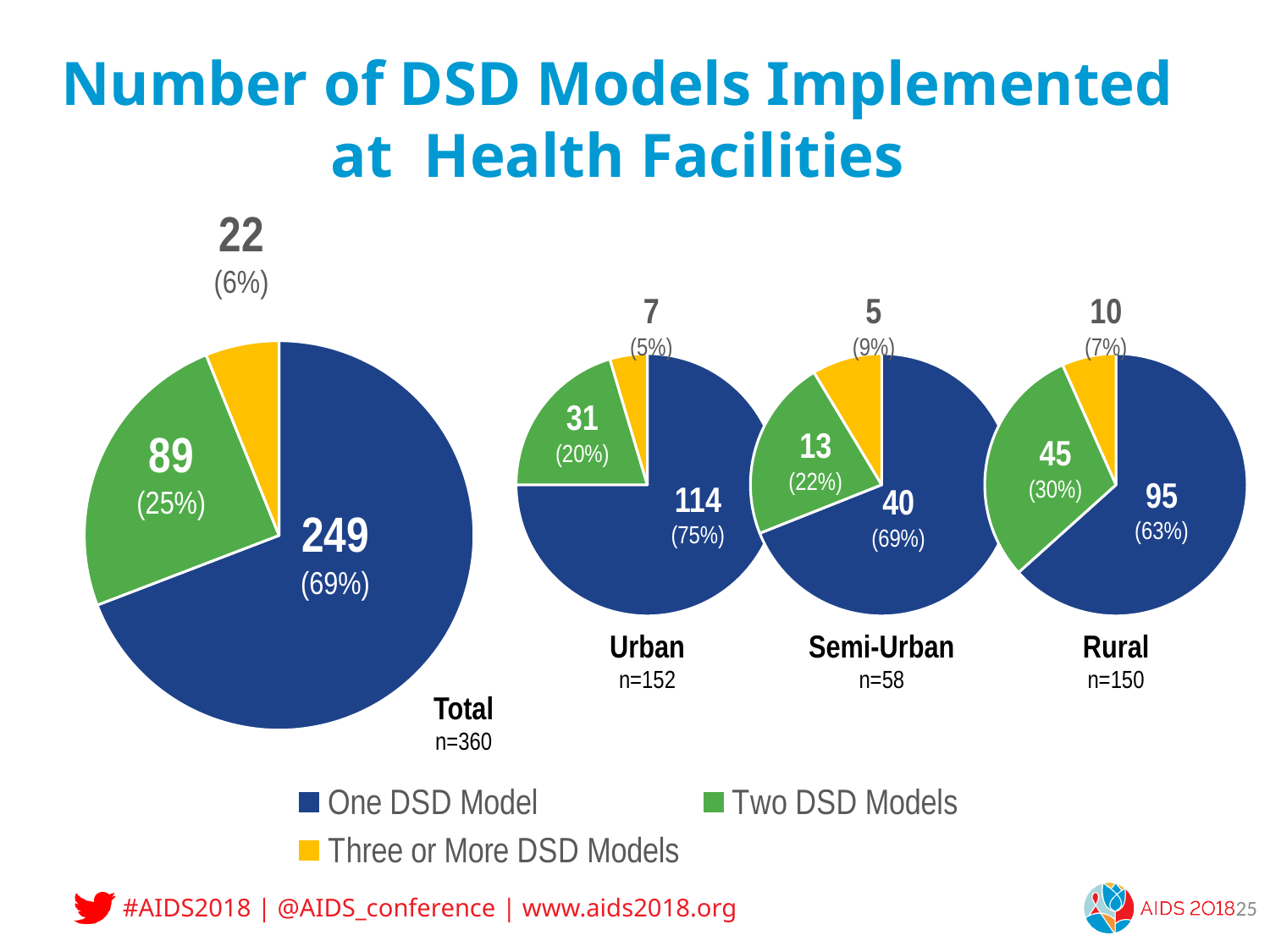
In the Rural pie chart, how many facilities implemented three or more DSD models? 10 Comparing the Urban and Rural pie charts, which has more facilities implementing two DSD models? Rural In the Total pie chart, how many health facilities implemented one DSD model? 249 In the Urban pie chart, what percentage of facilities implemented two DSD models? 20% In the Rural pie chart, what is the difference between the number of facilities with one DSD model and those with two DSD models? 50 How many categories does the legend list? 3 In the Total pie chart, which category has the smallest slice? Three or More DSD Models In the Semi-Urban pie chart, what share of facilities implemented three or more DSD models? 9% In the Semi-Urban pie chart, which category has the largest slice? One DSD Model What type of chart is used to show the number of DSD models implemented at health facilities? Pie chart How many pie charts are shown on the slide? 4 What is the sample size (n) shown for the Semi-Urban pie chart? n=58